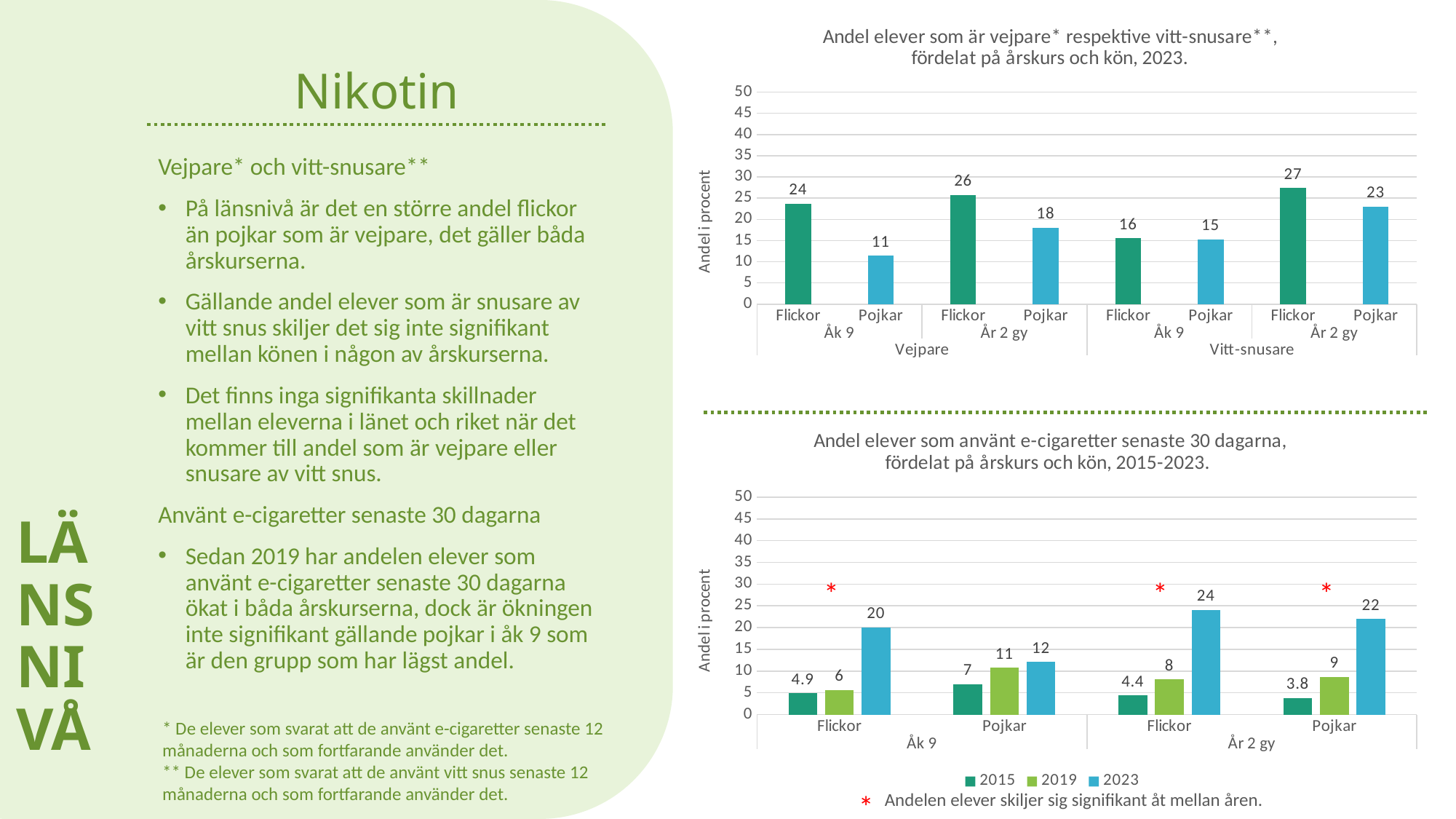
In the top chart (vejpare/vitt-snusare 2023), what is the value for Pojkar in Åk 9 under Vejpare? 11 In the top chart (vejpare/vitt-snusare 2023), what is the difference between Flickor and Pojkar in Åk 9 under Vejpare? 13 In the top chart (vejpare/vitt-snusare 2023), what is the value for Flickor in År 2 gy under Vitt-snusare? 27 In the bottom chart (e-cigaretter senaste 30 dagarna), do the values for Flickor in Åk 9 rise or fall from 2015 to 2023? Rise In the top chart (vejpare/vitt-snusare 2023), which bar has the highest value? Flickor, År 2 gy, Vitt-snusare (27) In the top chart (vejpare/vitt-snusare 2023), what kind of chart is it? Bar chart In the bottom chart (e-cigaretter senaste 30 dagarna), what is the difference between the 2023 and 2015 values for Flickor in År 2 gy? 19.6 In the top chart (vejpare/vitt-snusare 2023), how many bars are plotted? 8 In the bottom chart (e-cigaretter senaste 30 dagarna), which is larger for Pojkar in Åk 9: the 2019 value or the 2023 value? 2023 (12) In the bottom chart (e-cigaretter senaste 30 dagarna), what is the 2015 value for Flickor in Åk 9? 4.9 In the bottom chart (e-cigaretter senaste 30 dagarna), how many series does the legend list? 3 In the bottom chart (e-cigaretter senaste 30 dagarna), what is the 2023 value for Pojkar in År 2 gy? 22